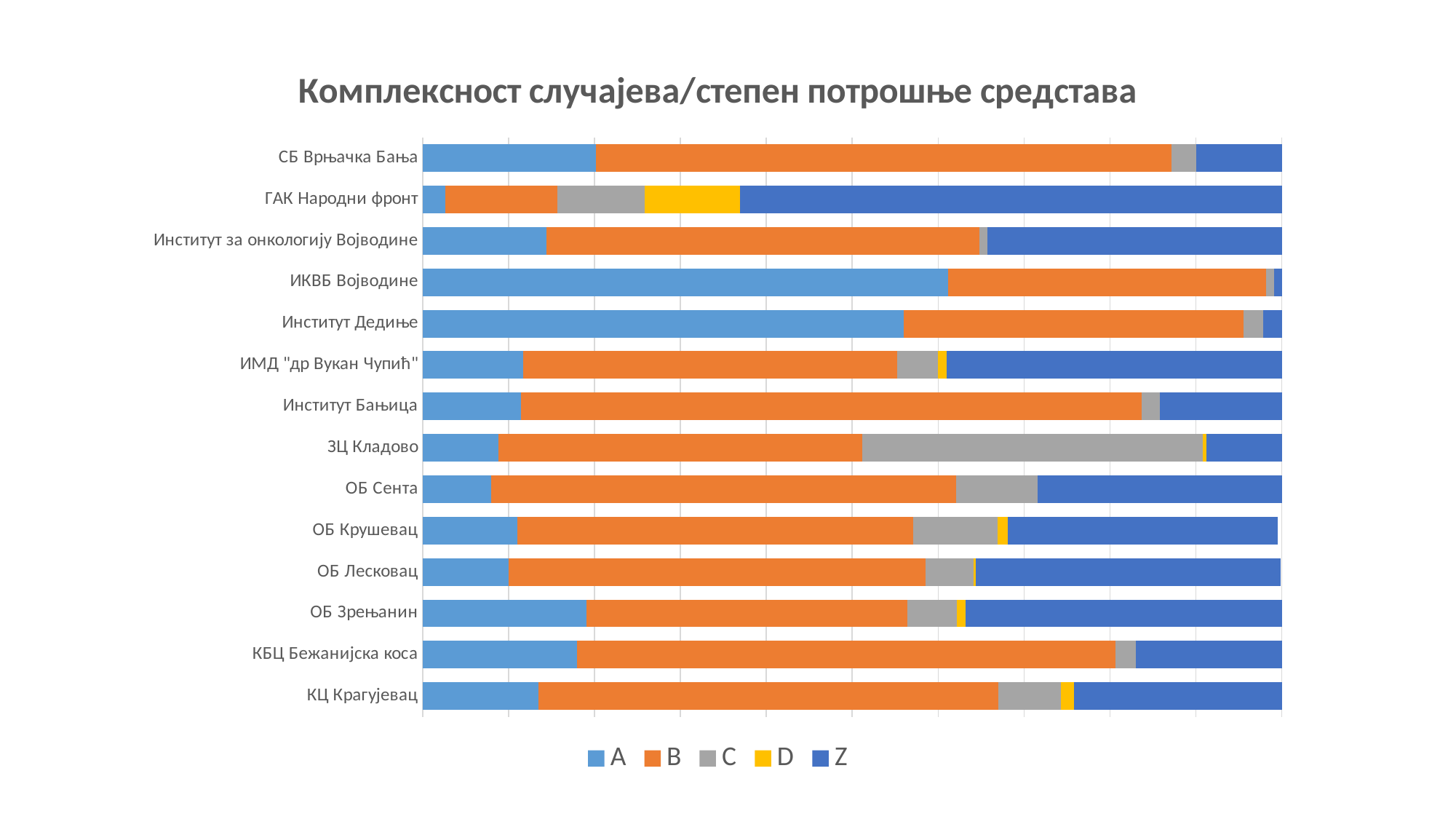
How many institutions (categories) are shown on the chart? 14 How many series does the legend list? 5 What kind of chart is shown on the slide? Stacked bar chart Which institution has the smallest share for series A? ГАК Народни фронт Which institution has the largest share for series Z? ГАК Народни фронт Which series are listed in the legend? A, B, C, D, Z Which institution has the largest share for series A? ИКВБ Војводине Which institution has the largest share for series C? ЗЦ Кладово Which has the larger share for series B: СБ Врњачка Бања or ГАК Народни фронт? СБ Врњачка Бања What is the title of the chart? Комплексност случајева/степен потрошње средстава Which has the larger share for series A: ИКВБ Војводине or ГАК Народни фронт? ИКВБ Војводине